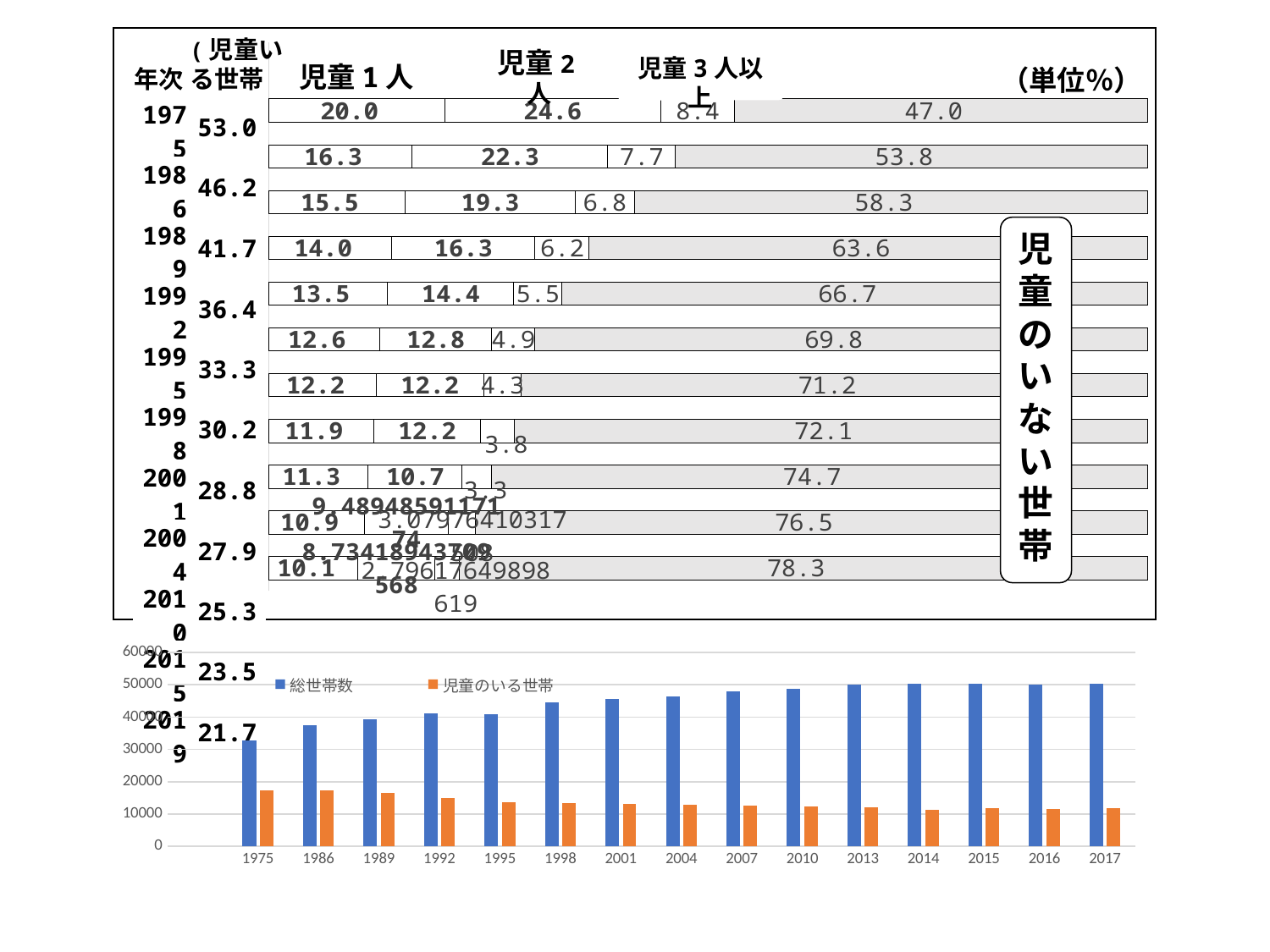
What kind of chart is the bottom chart? bar chart In the top chart, what is the value for 児童1人 in the topmost bar? 20.0 In the bottom chart, does 児童のいる世帯 rise or fall from 1975 to 2017? fall In the top chart, what is the value for 児童のいない世帯 in the topmost bar? 47.0 In the top chart, what is the difference between the 児童のいない世帯 values of the bottom bar and the topmost bar? 31.3 In the top chart, does the 児童のいない世帯 share rise or fall going from the top bar to the bottom bar? rise In the bottom chart, how many years are shown on the x axis? 15 In the bottom chart, which year has the lowest 総世帯数? 1975 In the bottom chart, how many series does the legend list? 2 In the top chart, how many stacked bars are plotted? 11 In the top chart, what is the value for 児童のいない世帯 in the bottom bar? 78.3 In the bottom chart, is the value for 総世帯数 in 1975 greater or less than 30000? greater